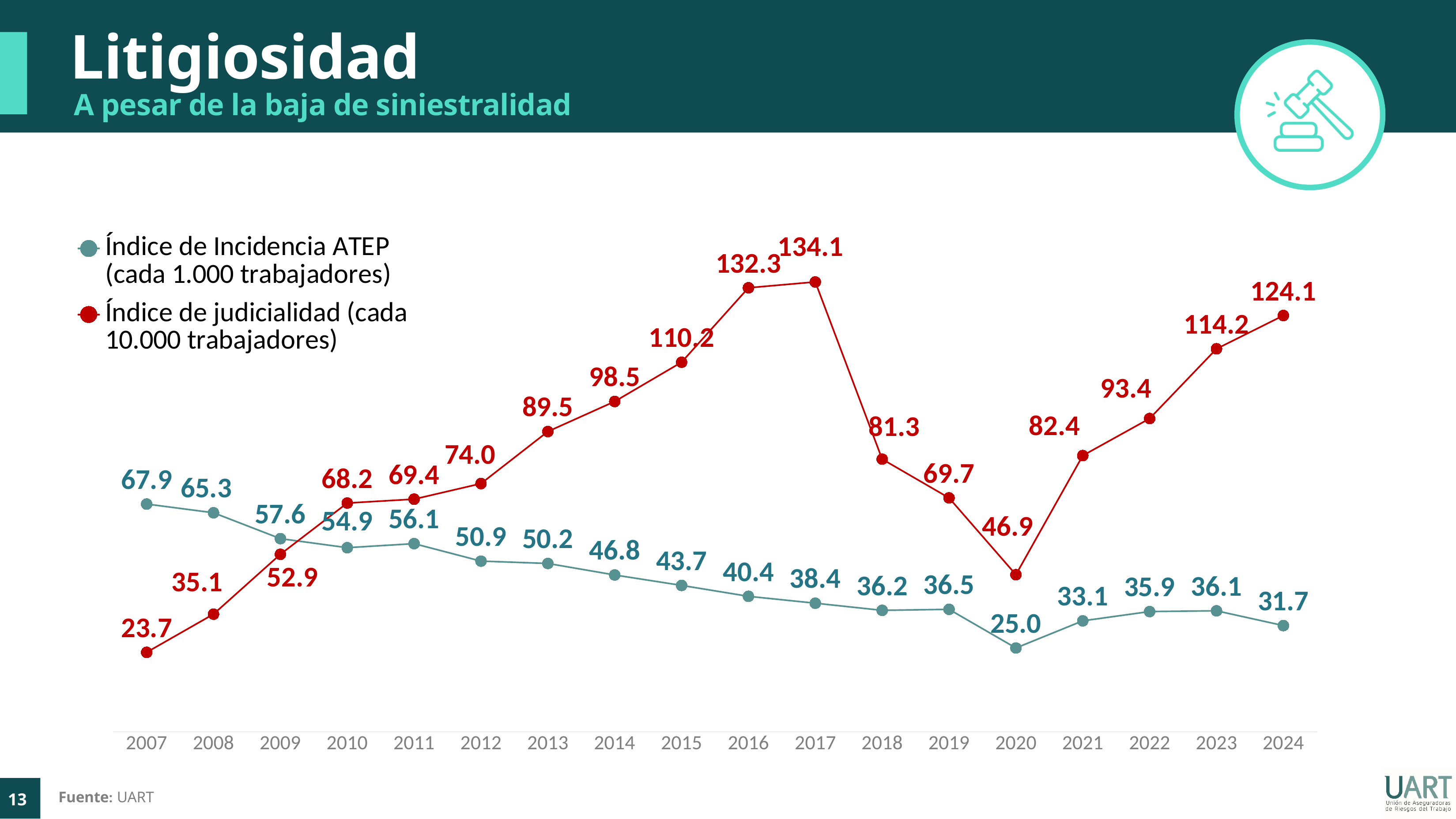
In which year is the Índice de judicialidad highest? 2017 How many years are shown on the x axis? 18 What is the value of the Índice de judicialidad in 2017? 134.1 By how much did the Índice de Incidencia ATEP fall from 2007 to 2024? 36.2 How many series does the legend list? 2 In which year is the Índice de Incidencia ATEP lowest? 2020 What is the difference between the Índice de judicialidad in 2024 and in 2023? 9.9 What is the value of the Índice de Incidencia ATEP in 2020? 25.0 In which year is the Índice de judicialidad lowest? 2007 Which is larger in 2009: the Índice de Incidencia ATEP or the Índice de judicialidad? Índice de Incidencia ATEP What kind of chart is shown on the slide? Line chart What is the value of the Índice de judicialidad in 2024? 124.1